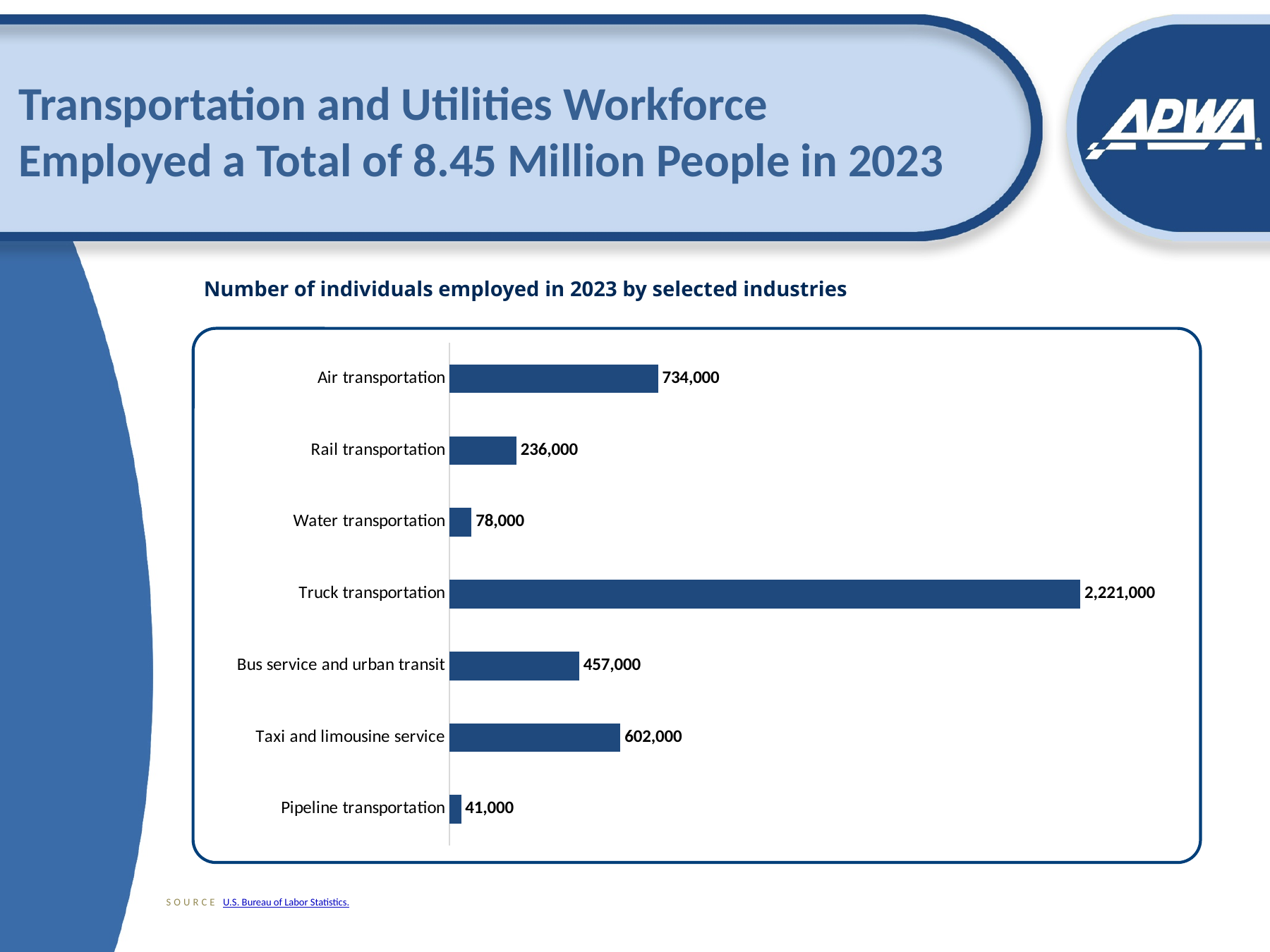
What is the difference between the values for Air transportation and Rail transportation? 498,000 How many individuals were employed in Truck transportation in 2023? 2,221,000 What is the difference between Taxi and limousine service and Bus service and urban transit? 145,000 Which is larger, the value for Air transportation or Taxi and limousine service? Air transportation Which is larger, the value for Rail transportation or Water transportation? Rail transportation Which industry has the lowest number of individuals employed? Pipeline transportation What kind of chart is shown on the slide? Bar chart What is the value shown for Water transportation? 78,000 What is the title of the chart? Number of individuals employed in 2023 by selected industries How many industries are shown in the chart? 7 Which industry has the highest number of individuals employed? Truck transportation How many people were employed in Bus service and urban transit? 457,000